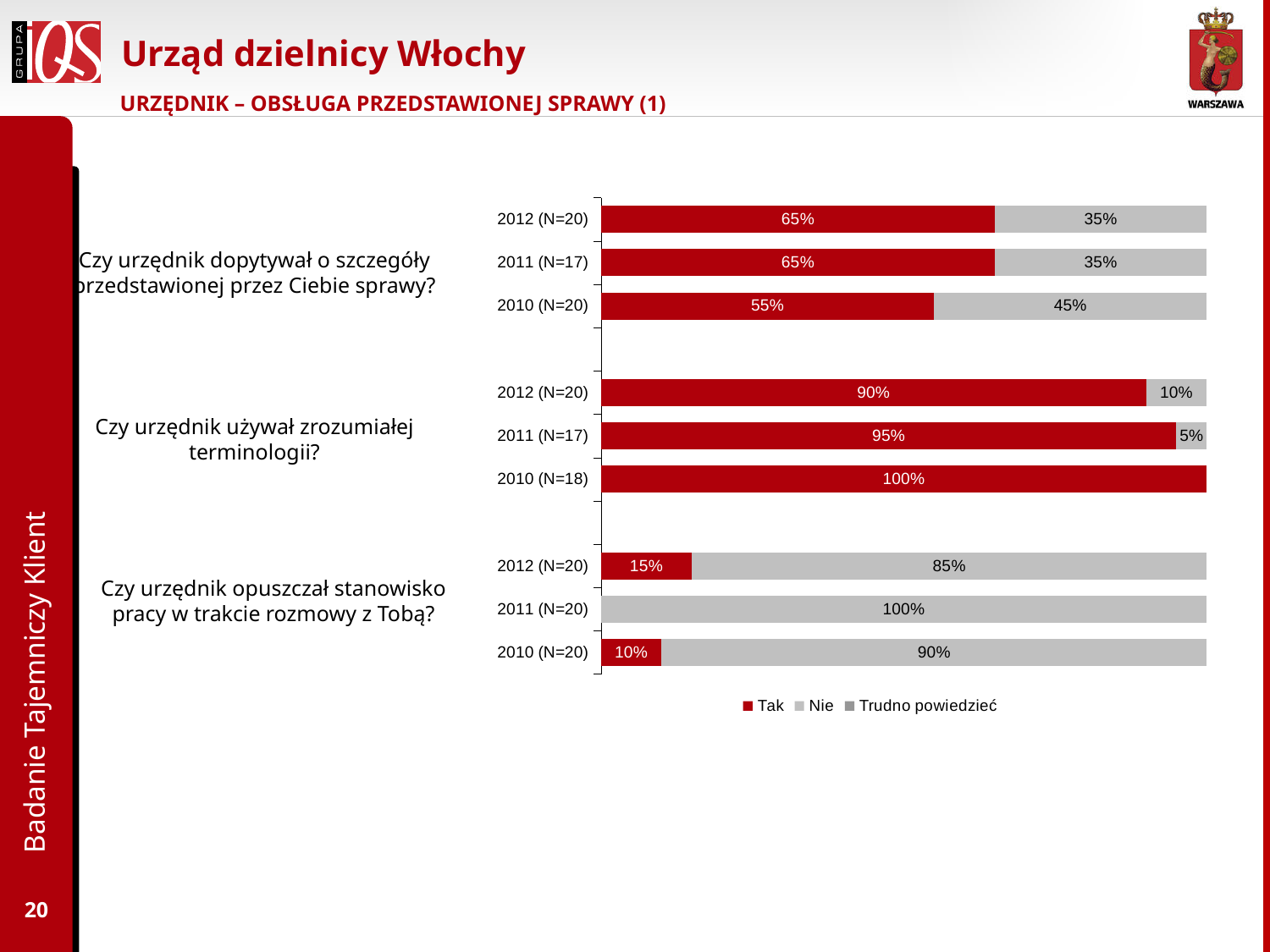
How many series does the legend list? 3 For the question "Czy urzędnik używał zrozumiałej terminologii?", what is the "Tak" value for 2011 (N=17)? 95% For the question "Czy urzędnik opuszczał stanowisko pracy w trakcie rozmowy z Tobą?", what is the "Tak" value for 2010 (N=20)? 10% What kind of chart is shown on the slide? stacked bar chart What are the legend entries of the chart? Tak, Nie, Trudno powiedzieć For the question "Czy urzędnik dopytywał o szczegóły przedstawionej przez Ciebie sprawy?", what is the "Tak" value for 2010 (N=20)? 55% For the question "Czy urzędnik używał zrozumiałej terminologii?", does the "Tak" value rise or fall from 2010 to 2012? fall For the question "Czy urzędnik używał zrozumiałej terminologii?", is the "Tak" value larger for 2012 (N=20) or 2011 (N=17)? 2011 (N=17) For the question "Czy urzędnik dopytywał o szczegóły przedstawionej przez Ciebie sprawy?", what is the difference between the "Tak" values for 2012 (N=20) and 2010 (N=20)? 10% For the question "Czy urzędnik używał zrozumiałej terminologii?", which year has the highest "Tak" value? 2010 (N=18) For the question "Czy urzędnik opuszczał stanowisko pracy w trakcie rozmowy z Tobą?", what is the "Nie" value for 2012 (N=20)? 85% For the question "Czy urzędnik dopytywał o szczegóły przedstawionej przez Ciebie sprawy?", what is the "Nie" value for 2012 (N=20)? 35%